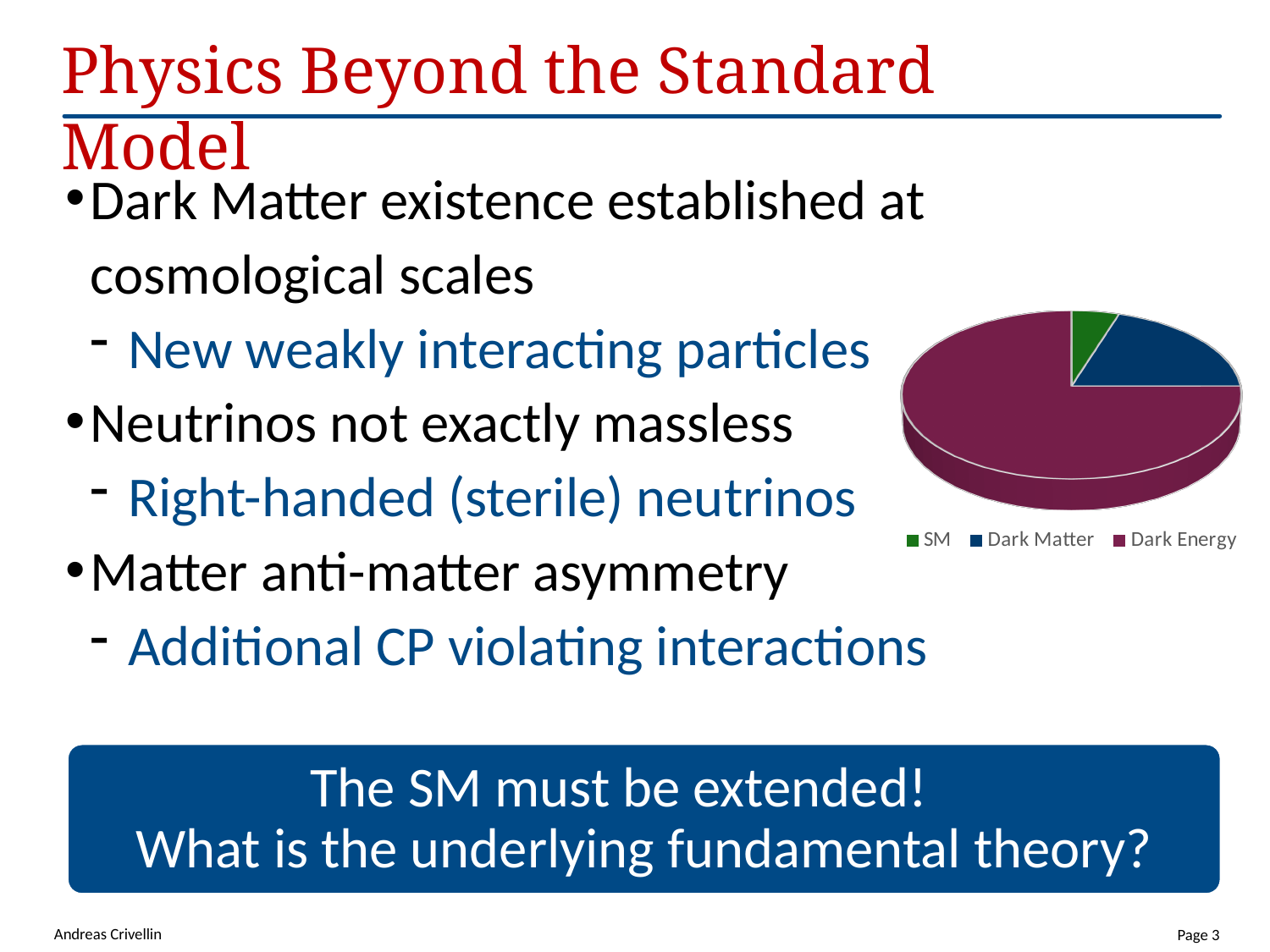
Which category has the largest slice of the pie chart? Dark Energy What colour is the Dark Energy slice in the pie chart? purple How many entries does the pie chart's legend list? 3 What are the legend entries of the pie chart, in order? SM, Dark Matter, Dark Energy Which slice is larger in the pie chart, Dark Matter or SM? Dark Matter Which category has the smallest slice of the pie chart? SM How many slices does the pie chart have? 3 Which slice is larger in the pie chart, Dark Energy or Dark Matter? Dark Energy What kind of chart is shown on the slide? pie chart